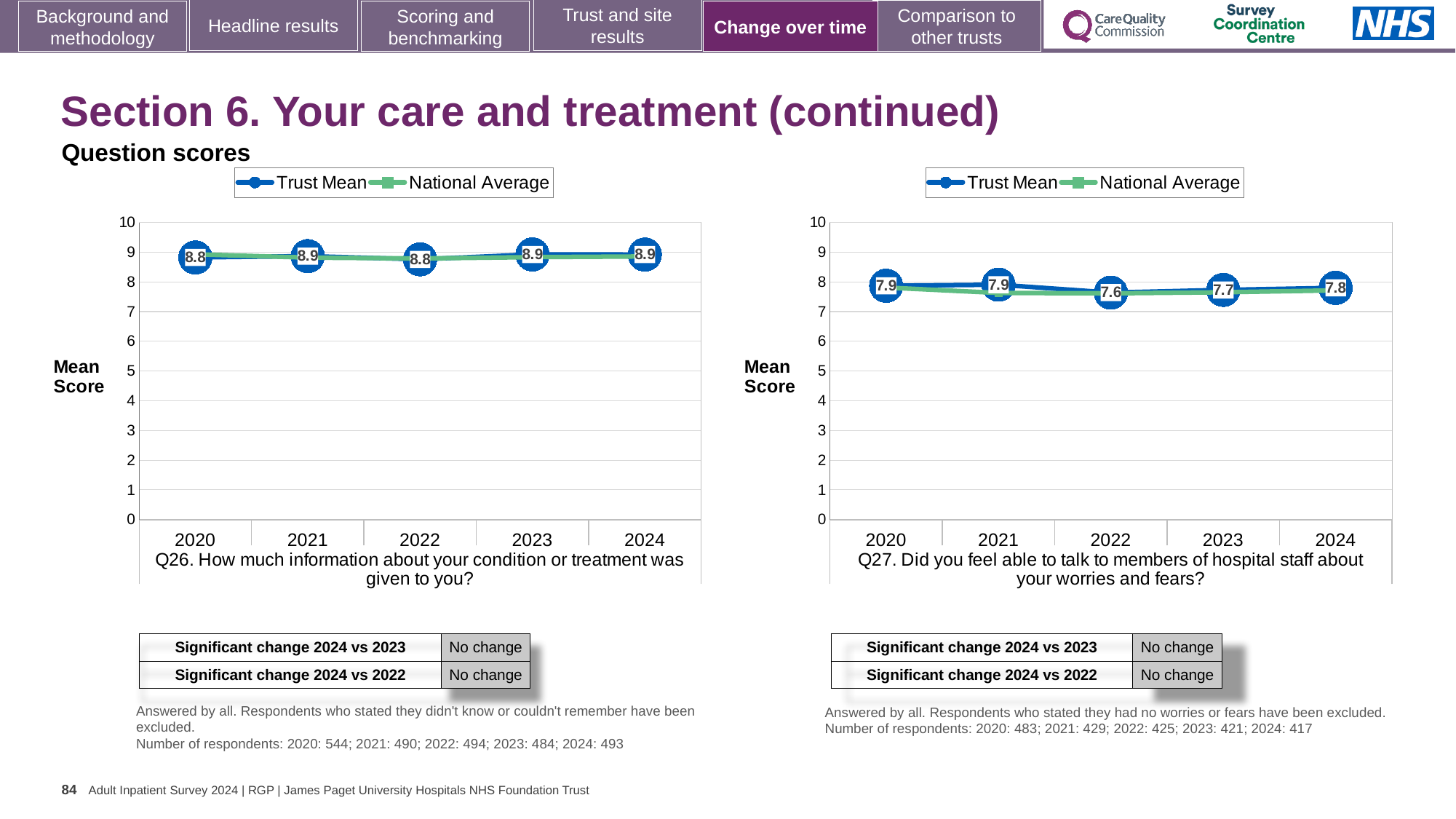
In the Q26 chart (left), is the National Average value for 2024 greater or less than 8? greater In the Q27 chart (right), is the National Average value for 2022 greater or less than 7? greater In the Q26 chart (left), what is the Trust Mean score for 2024? 8.9 In the Q26 chart (left), what is the difference between the Trust Mean scores for 2023 and 2022? 0.1 In the Q27 chart (right), is the Trust Mean score higher in 2021 or in 2022? 2021 How many series does the legend of the Q27 chart (right) list? 2 In the Q27 chart (right), which year has the lowest Trust Mean score? 2022 How many years are plotted on the x axis of the Q26 chart (left)? 5 In the Q26 chart (left), what is the Trust Mean score for 2020? 8.8 What type of chart is used for Q26 (left)? Line chart In the Q27 chart (right), what is the Trust Mean score for 2022? 7.6 In the Q27 chart (right), what is the difference between the Trust Mean scores for 2021 and 2022? 0.3